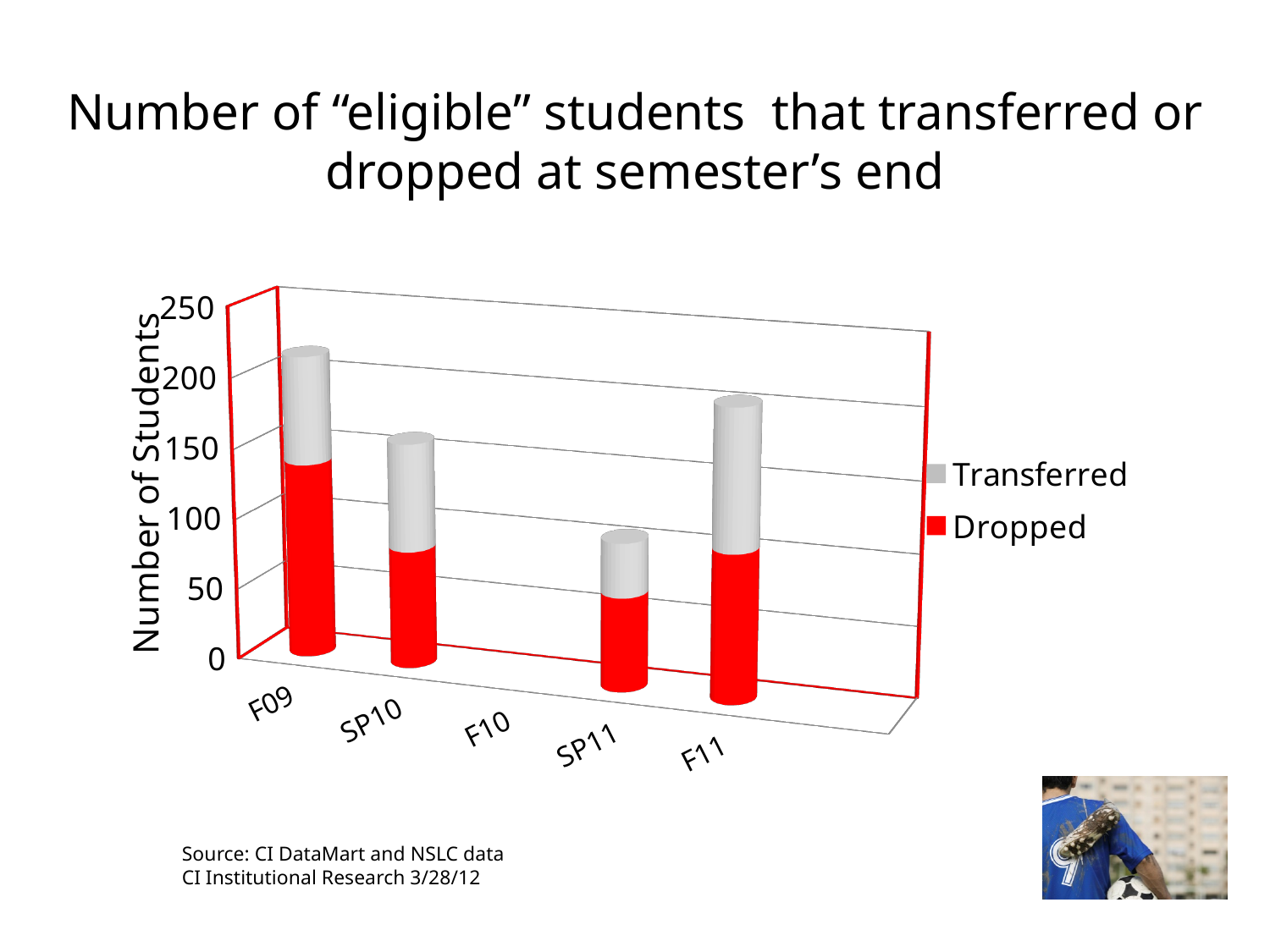
Is the number of Dropped students for F09 greater or less than 100? greater How many semester categories are labelled on the x axis? 5 What is the title of the vertical axis? Number of Students Which has the larger Dropped segment, F09 or SP11? F09 Which colour represents the Dropped series? red Is the total number of students for F09 greater or less than 150? greater How many series does the legend list? 2 Which has the larger total bar, F09 or SP10? F09 What kind of chart is shown on the slide? bar chart Which has the larger total bar, F11 or SP11? F11 Is the total number of students for SP11 greater or less than 150? less